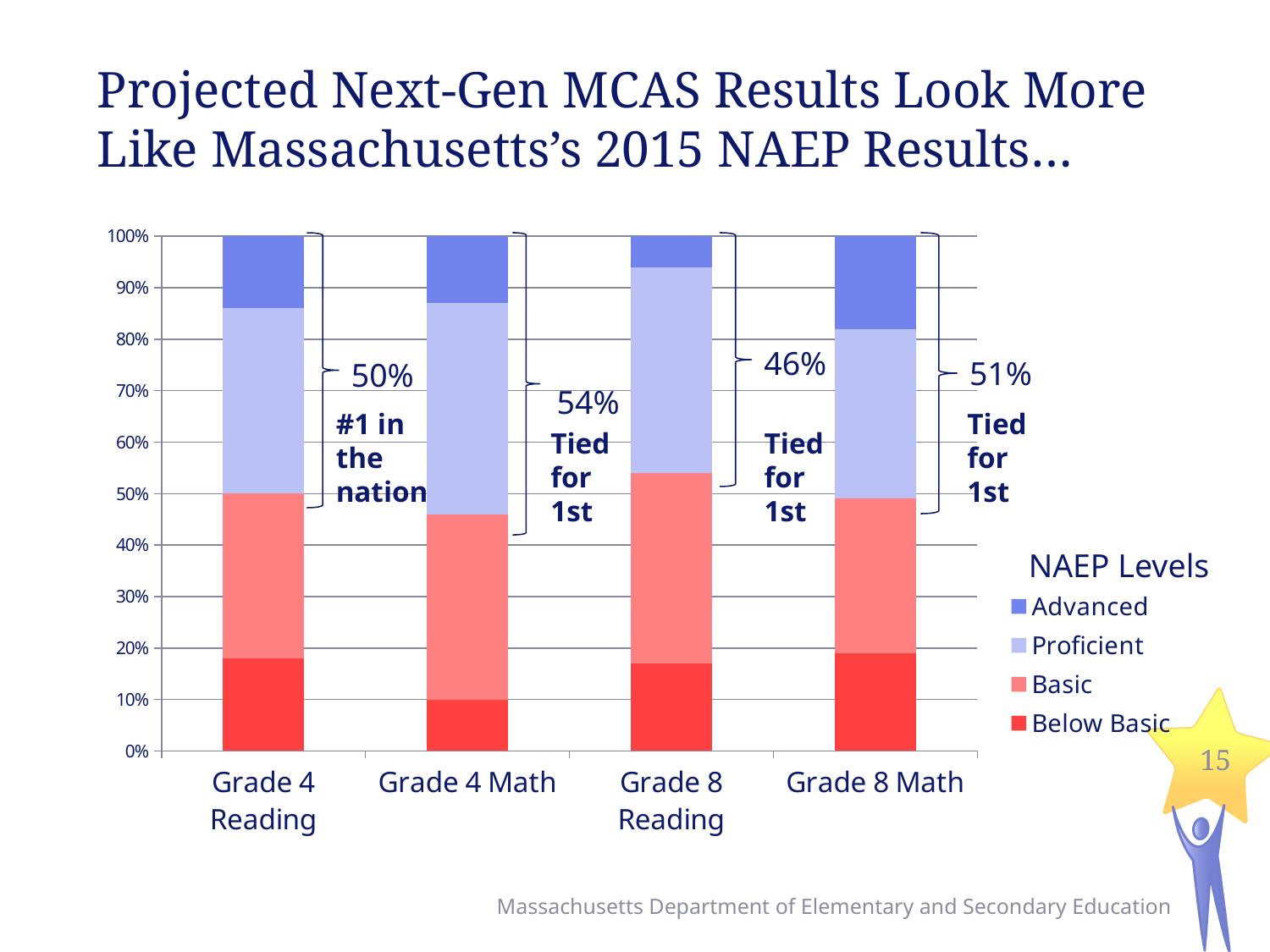
Which has a larger labelled Proficient-plus-Advanced percentage, Grade 4 Reading or Grade 8 Math? Grade 8 Math What combined Proficient and Advanced percentage is labelled for Grade 4 Math? 54% Which category has the highest labelled Proficient-plus-Advanced percentage? Grade 4 Math How many NAEP levels does the legend list? 4 How many grade/subject categories are plotted on the x axis? 4 What is the title of the chart's legend? NAEP Levels Is the Advanced share for Grade 8 Reading greater or less than 10%? less What combined Proficient and Advanced percentage is labelled for Grade 4 Reading? 50% What is the difference between the labelled Proficient-plus-Advanced percentages for Grade 4 Math and Grade 8 Reading? 8 percentage points What kind of chart is shown on the slide? stacked bar chart Which category has the lowest labelled Proficient-plus-Advanced percentage? Grade 8 Reading What combined Proficient and Advanced percentage is labelled for Grade 8 Reading? 46%